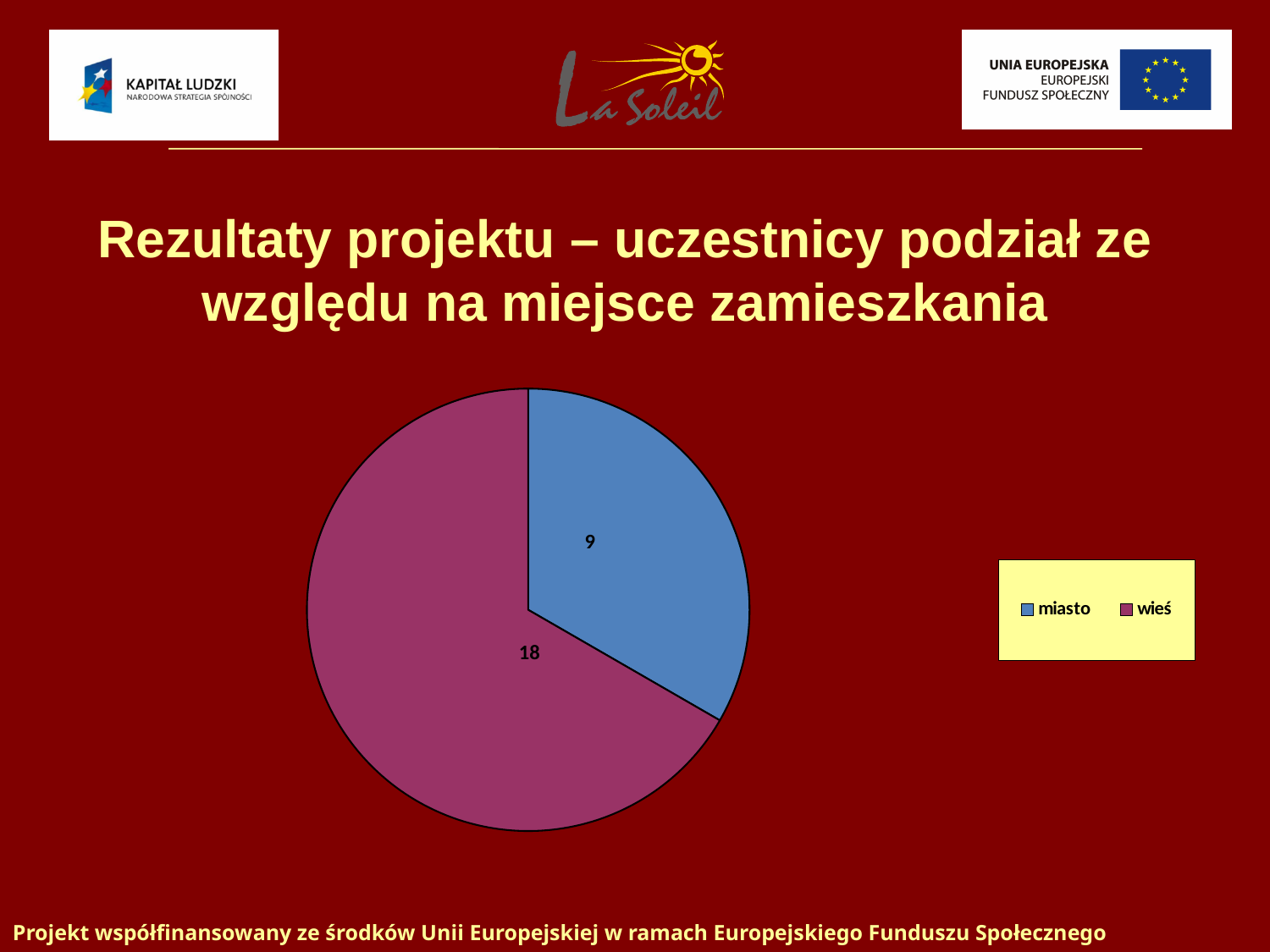
What is the value for miasto? 9 Which category has the largest slice? wieś What is the value for wieś? 18 Which category has the smallest slice? miasto What kind of chart is shown on the slide? pie chart How many entries does the legend list? 2 How many slices does the pie chart have? 2 Which is larger, miasto or wieś? wieś What colour is the slice for miasto? blue What is the difference between the values for wieś and miasto? 9 What colour is the slice for wieś? purple What is the total of all slices in the pie chart? 27